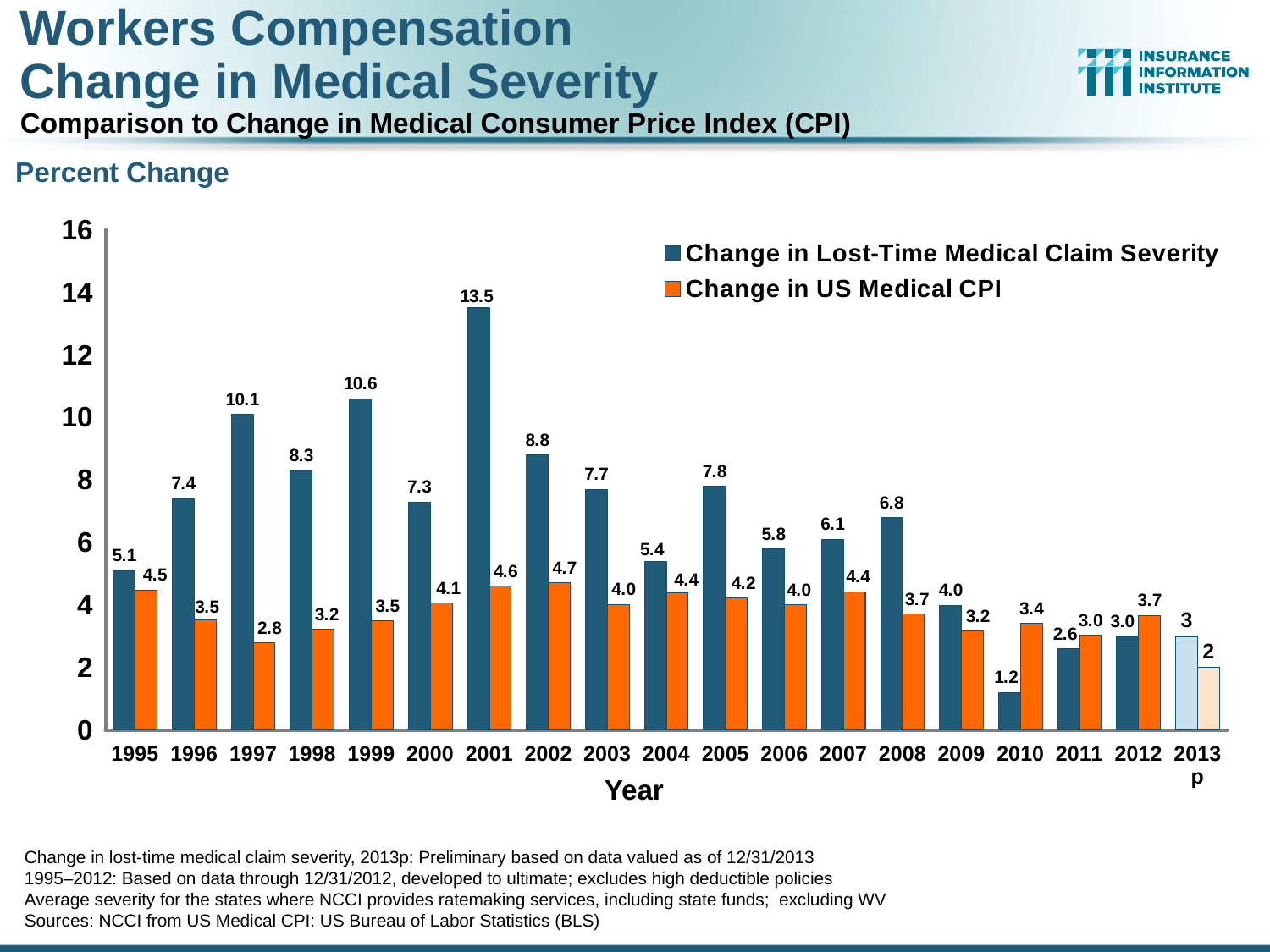
In 2010, which is larger: the Change in Lost-Time Medical Claim Severity or the Change in US Medical CPI? Change in US Medical CPI How many years are shown on the x axis? 19 How many series does the legend list? 2 What kind of chart is shown on the slide? Bar chart Which year has the lowest Change in Lost-Time Medical Claim Severity? 2010 Which year has the highest Change in Lost-Time Medical Claim Severity? 2001 What is the Change in Lost-Time Medical Claim Severity for 2001? 13.5 Which year has the highest Change in US Medical CPI? 2002 What is the difference between the Change in Lost-Time Medical Claim Severity and the Change in US Medical CPI in 1999? 7.1 What is the Change in US Medical CPI for 2013p? 2 What is the Change in US Medical CPI for 1997? 2.8 What is the label of the x axis? Year